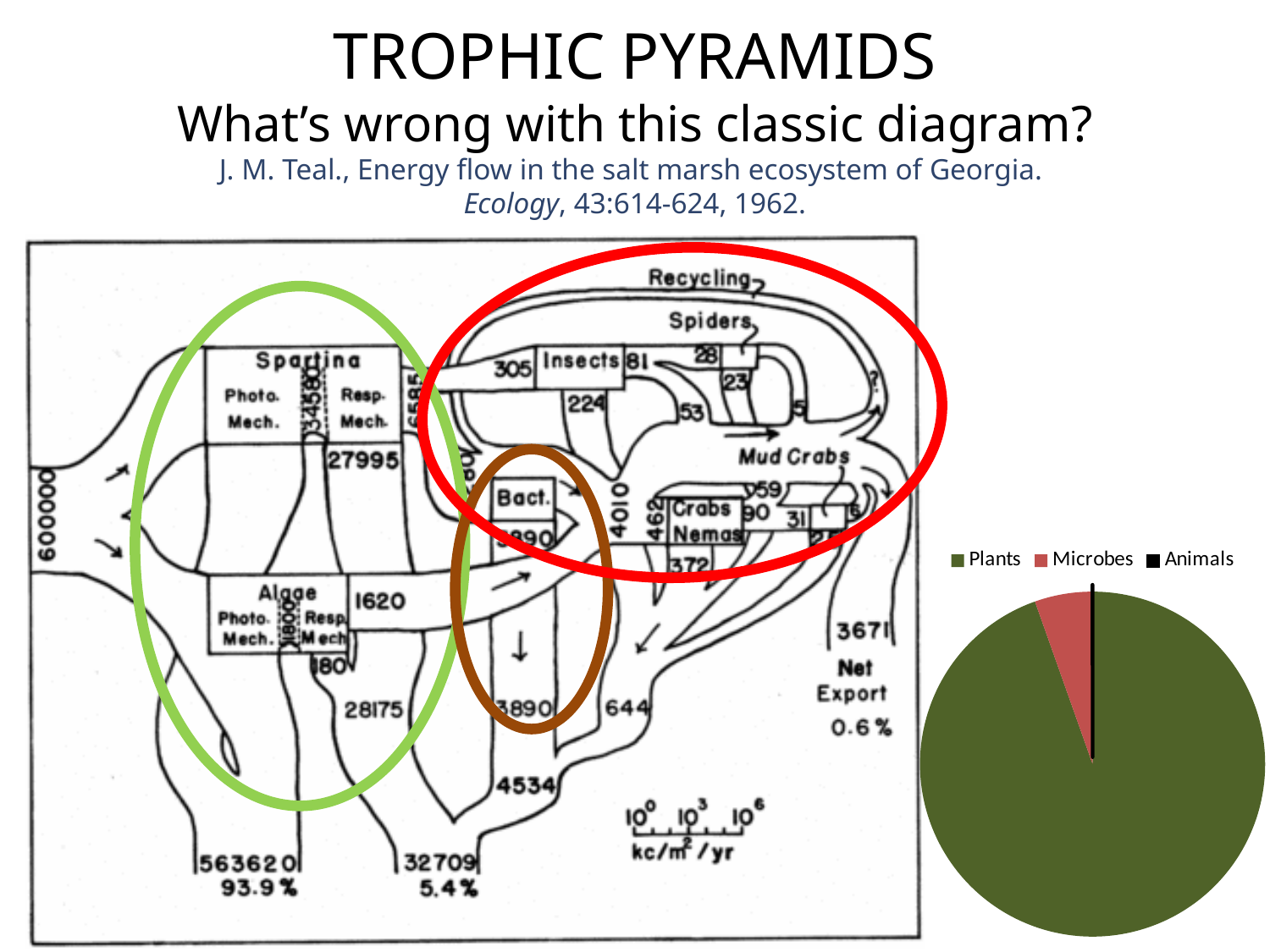
Which category takes up the smallest share of the pie chart? Animals What colour does the legend use for Animals in the pie chart? Black Which category takes up the largest share of the pie chart? Plants What colour is the Plants slice in the pie chart? Green In the pie chart, which is larger, the slice for Plants or the slice for Microbes? Plants How many categories does the legend of the pie chart list? 3 In the pie chart, which is larger, the slice for Microbes or the slice for Animals? Microbes What kind of chart is shown on the right side of the slide? Pie chart What are the three categories listed in the pie chart's legend? Plants, Microbes, Animals